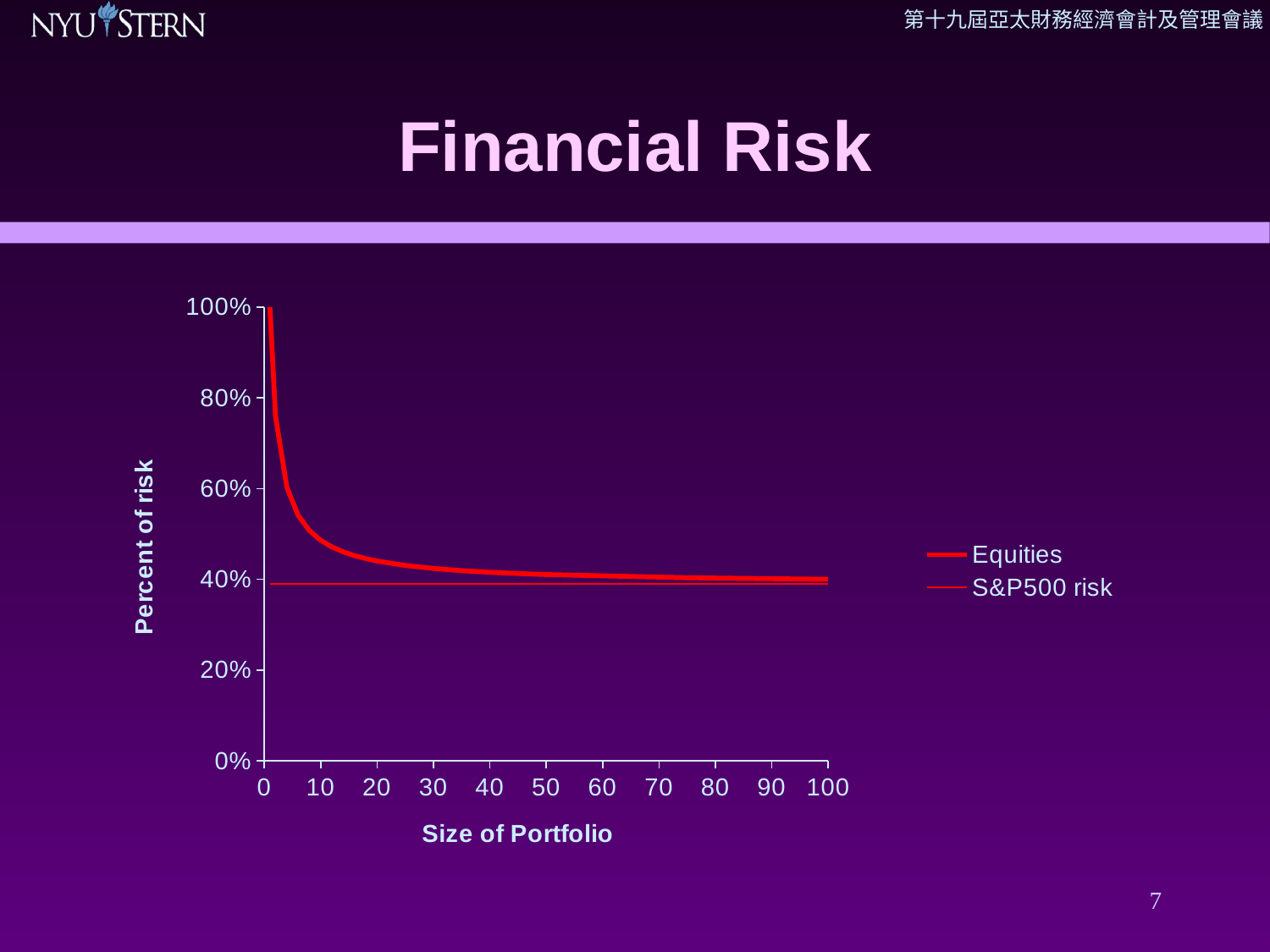
What kind of chart is shown on the slide? line chart What are the two series named in the legend? Equities and S&P500 risk Does the Equities line rise or fall as Size of Portfolio increases? fall What is the title of the chart? Financial Risk At a portfolio size of 5, which series has the higher value, Equities or S&P500 risk? Equities How many series does the legend list? 2 Is the Equities value at a portfolio size of 100 greater or less than 20%? greater Is the S&P500 risk line greater or less than 60%? less What is the highest value reached by the Equities line? 100% Is the Equities value at a portfolio size of 5 greater or less than 40%? greater Which series is drawn as a flat horizontal line? S&P500 risk